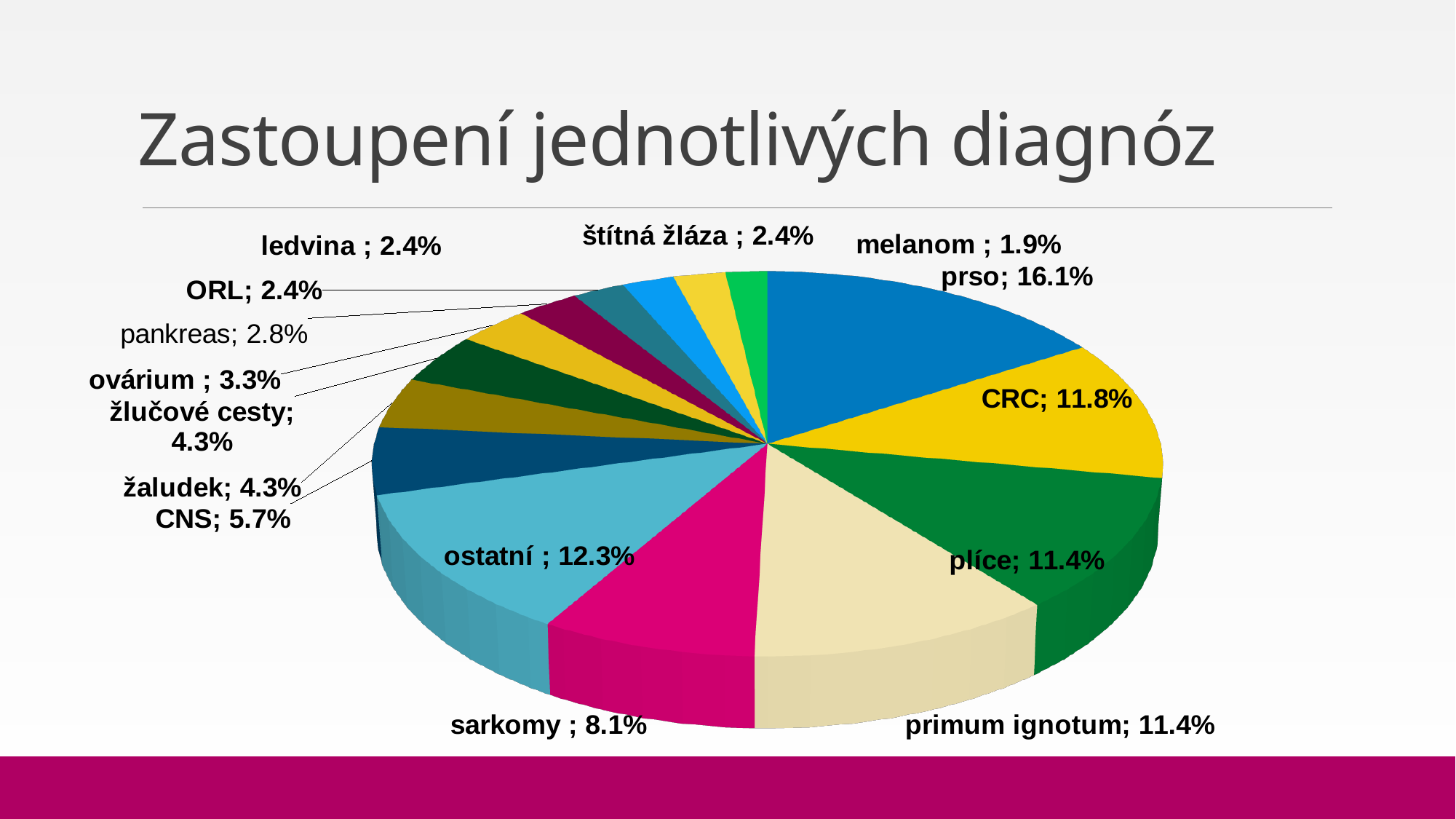
What is the value shown for CNS? 5.7% What is the value shown for ostatní? 12.3% What is the difference between the shares of prso and CRC? 4.3% Which diagnosis has the smallest share of the pie? melanom What is the title of the chart? Zastoupení jednotlivých diagnóz What share of the pie does CRC represent? 11.8% How many slices does the pie chart have? 15 What is the value shown for pankreas? 2.8% Which is larger, the share for ostatní or the share for plíce? ostatní What is the value shown for sarkomy? 8.1% What kind of chart is shown on the slide? pie chart Which diagnosis has the largest share of the pie? prso